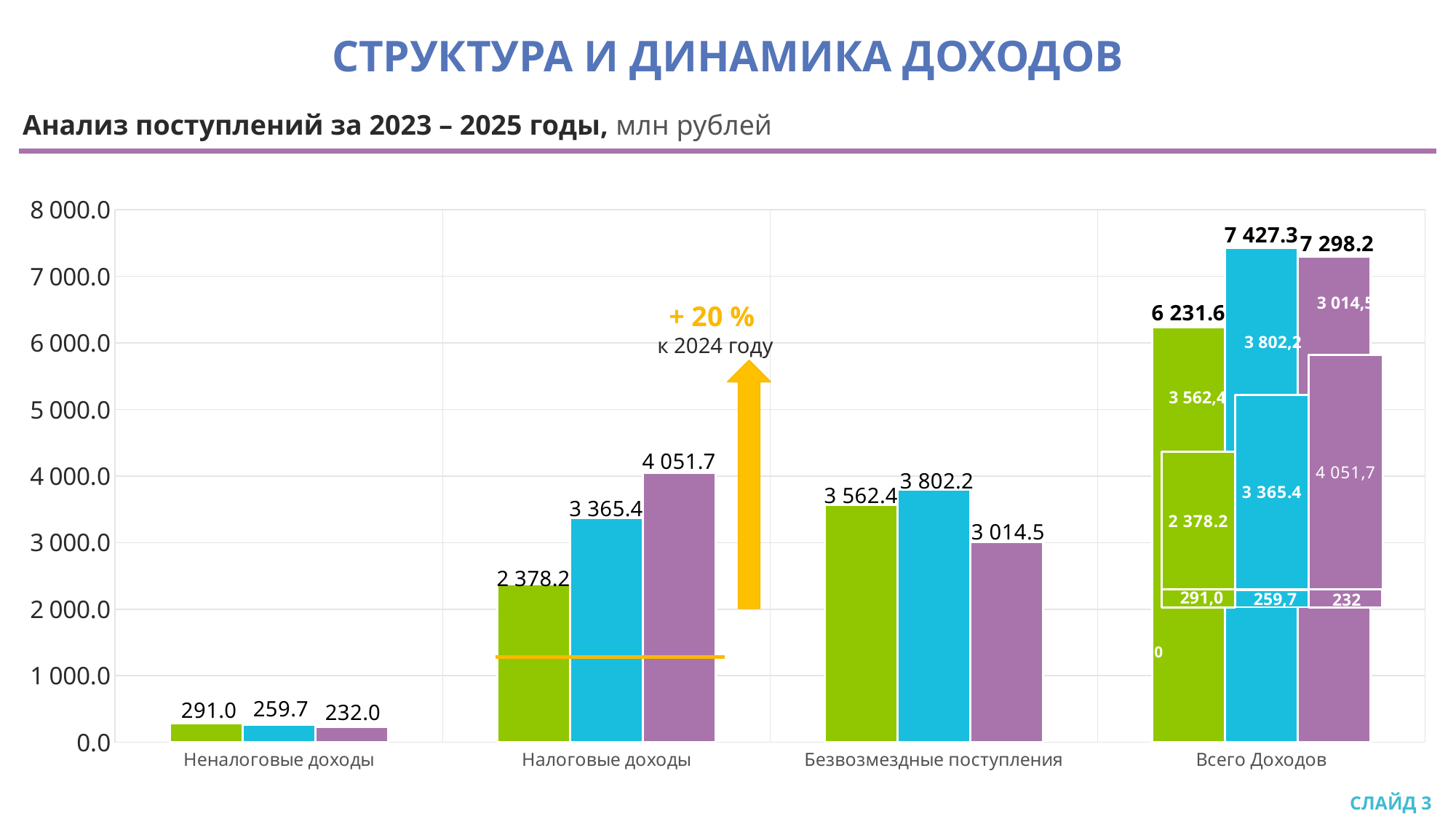
Which bar is the highest in the Всего Доходов group: green, blue or purple? blue Which category has the lowest values in the chart? Неналоговые доходы What is the value of the blue bar for Безвозмездные поступления? 3 802.2 What percentage change is annotated above the Налоговые доходы bars? + 20 % Which is larger for Безвозмездные поступления: the green bar or the purple bar? the green bar How many categories are shown on the x axis of the chart? 4 What is the difference between the purple and green bars for Налоговые доходы? 1 673.5 Do the values for Налоговые доходы rise or fall from the green bar to the purple bar? rise What is the value of the green bar for Налоговые доходы? 2 378.2 What kind of chart is shown on the slide? bar chart What is the value of the purple bar for Налоговые доходы? 4 051.7 What is the value of the blue bar for Всего Доходов? 7 427.3